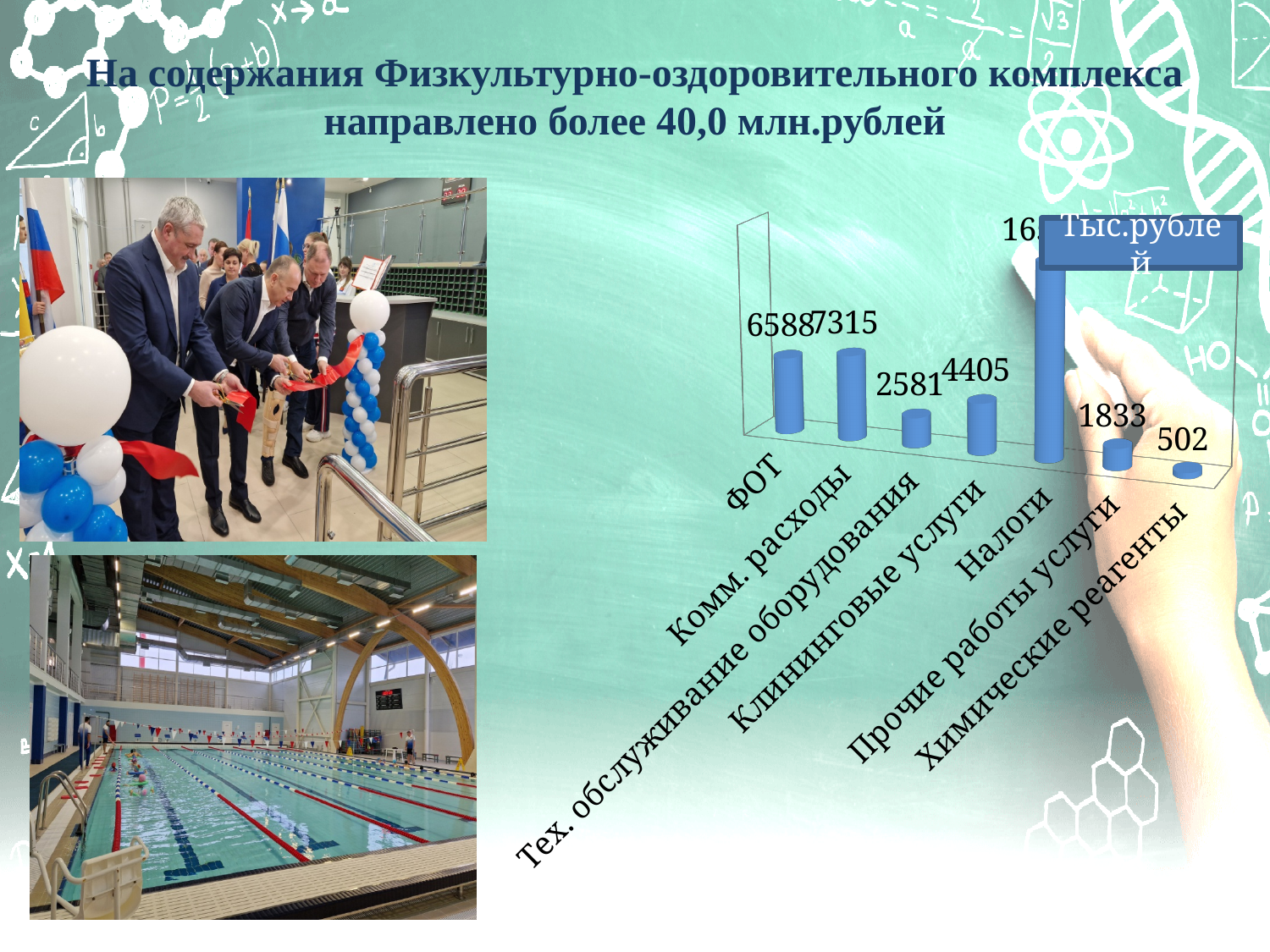
Which is larger, Клининговые услуги or Тех. обслуживание оборудования? Клининговые услуги Which category has the highest value? Налоги What kind of chart is shown on the slide? Bar chart What is the value for ФОТ? 6588 What is the value for Химические реагенты? 502 What is the value for Клининговые услуги? 4405 What is the difference between Комм. расходы and ФОТ? 727 What is the value for Тех. обслуживание оборудования? 2581 Which category has the lowest value? Химические реагенты What is the value for Комм. расходы? 7315 What is the value for Прочие работы услуги? 1833 How many categories are shown in the chart? 7